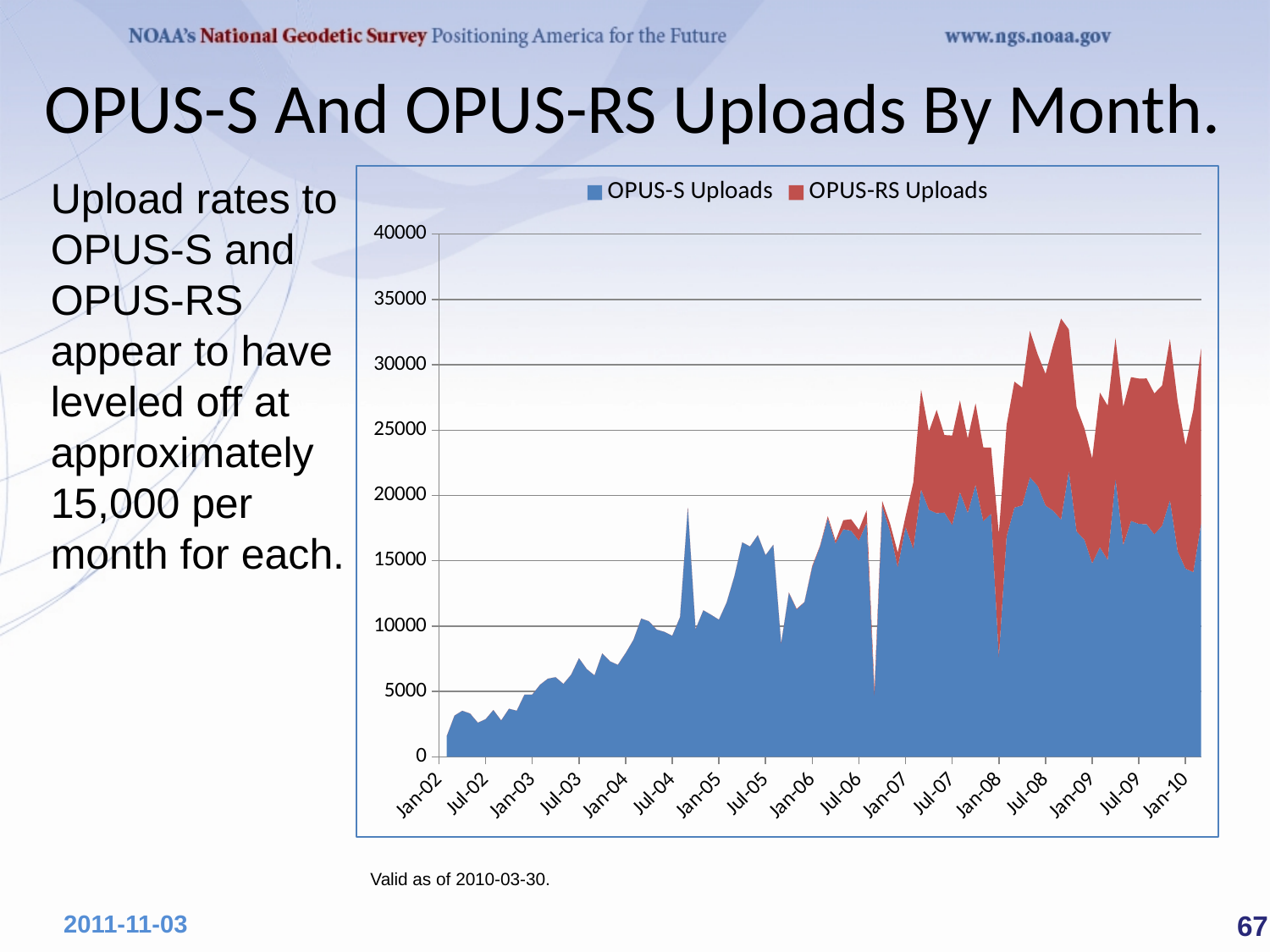
Is the combined stacked total of OPUS-S and OPUS-RS uploads at its peak around Jul-08 greater or less than 30000? greater Is the value for OPUS-S Uploads at Jan-02 greater or less than 5000? less Which colour represents OPUS-RS Uploads in the chart? Red Is the value for OPUS-S Uploads at Jan-04 greater or less than 10000? less What is the highest value shown on the chart's vertical axis? 40000 What are the two series named in the chart legend? OPUS-S Uploads and OPUS-RS Uploads Overall, do OPUS-S Uploads rise or fall from Jan-02 to Jan-10? Rise How many series does the chart legend list? 2 What is the last month label on the chart's horizontal axis? Jan-10 What is the first month label on the chart's horizontal axis? Jan-02 How many month labels are shown along the chart's horizontal axis? 17 What kind of chart is shown on the slide? Stacked area chart